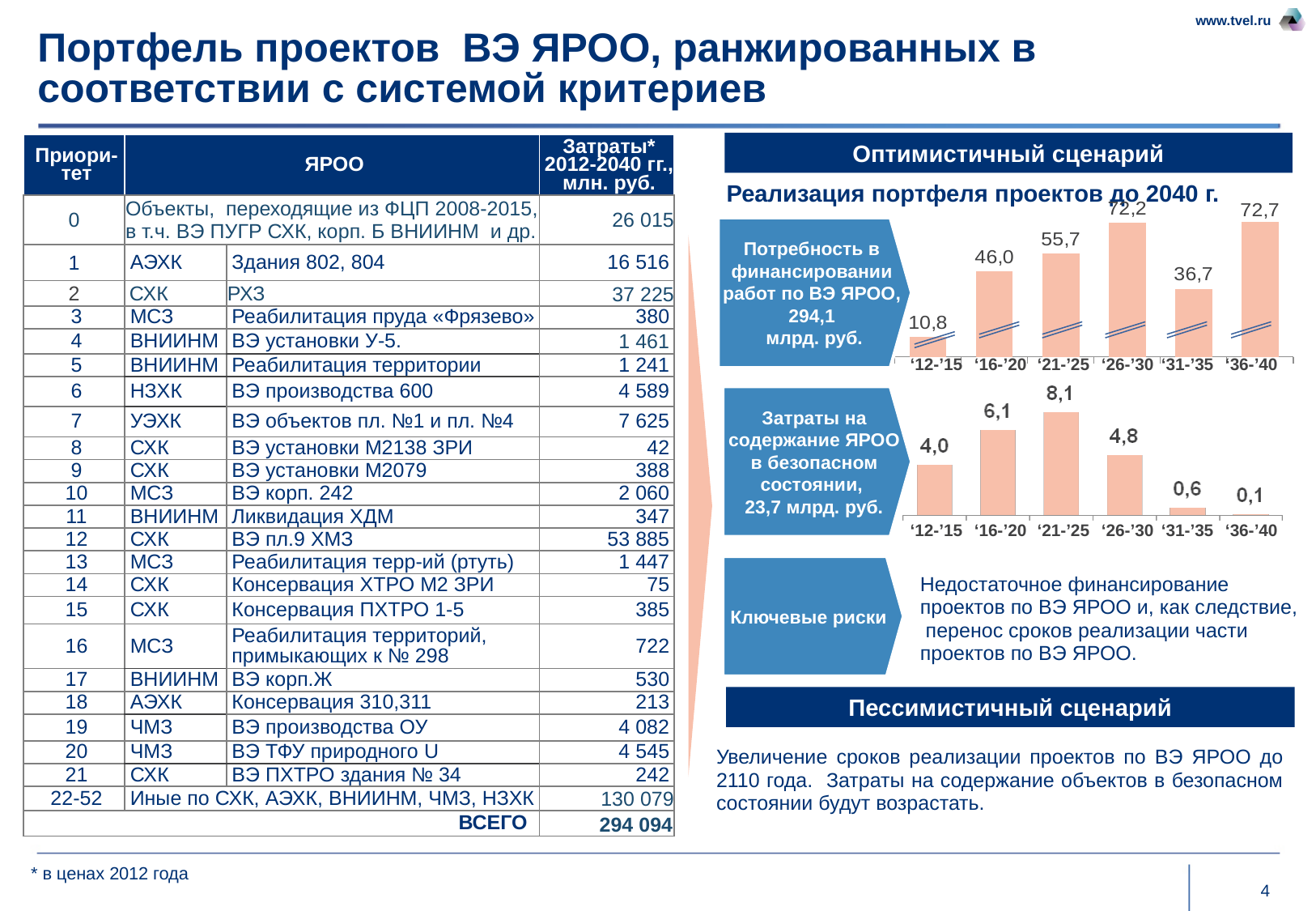
On the lower chart (Затраты на содержание ЯРОО в безопасном состоянии), which period has the highest value? '21-'25 On the lower chart (Затраты на содержание ЯРОО в безопасном состоянии), which period has the lowest value? '36-'40 On the upper chart (Потребность в финансировании работ по ВЭ ЯРОО), which is larger: the value for '16-'20 or the value for '31-'35? '16-'20 On the upper chart (Потребность в финансировании работ по ВЭ ЯРОО), what is the value for '21-'25? 55,7 On the upper chart (Потребность в финансировании работ по ВЭ ЯРОО), what is the difference between the values for '26-'30 and '31-'35? 35,5 On the lower chart (Затраты на содержание ЯРОО в безопасном состоянии), do the values rise or fall from '21-'25 to '36-'40? fall On the upper chart (Потребность в финансировании работ по ВЭ ЯРОО), how many periods are plotted? 6 On the lower chart (Затраты на содержание ЯРОО в безопасном состоянии), what is the difference between the values for '21-'25 and '26-'30? 3,3 On the upper chart (Потребность в финансировании работ по ВЭ ЯРОО), what is the value for '12-'15? 10,8 On the lower chart (Затраты на содержание ЯРОО в безопасном состоянии), what is the value for '16-'20? 6,1 On the upper chart (Потребность в финансировании работ по ВЭ ЯРОО), which period has the lowest value? '12-'15 What type of chart is the lower chart (Затраты на содержание ЯРОО в безопасном состоянии)? bar chart